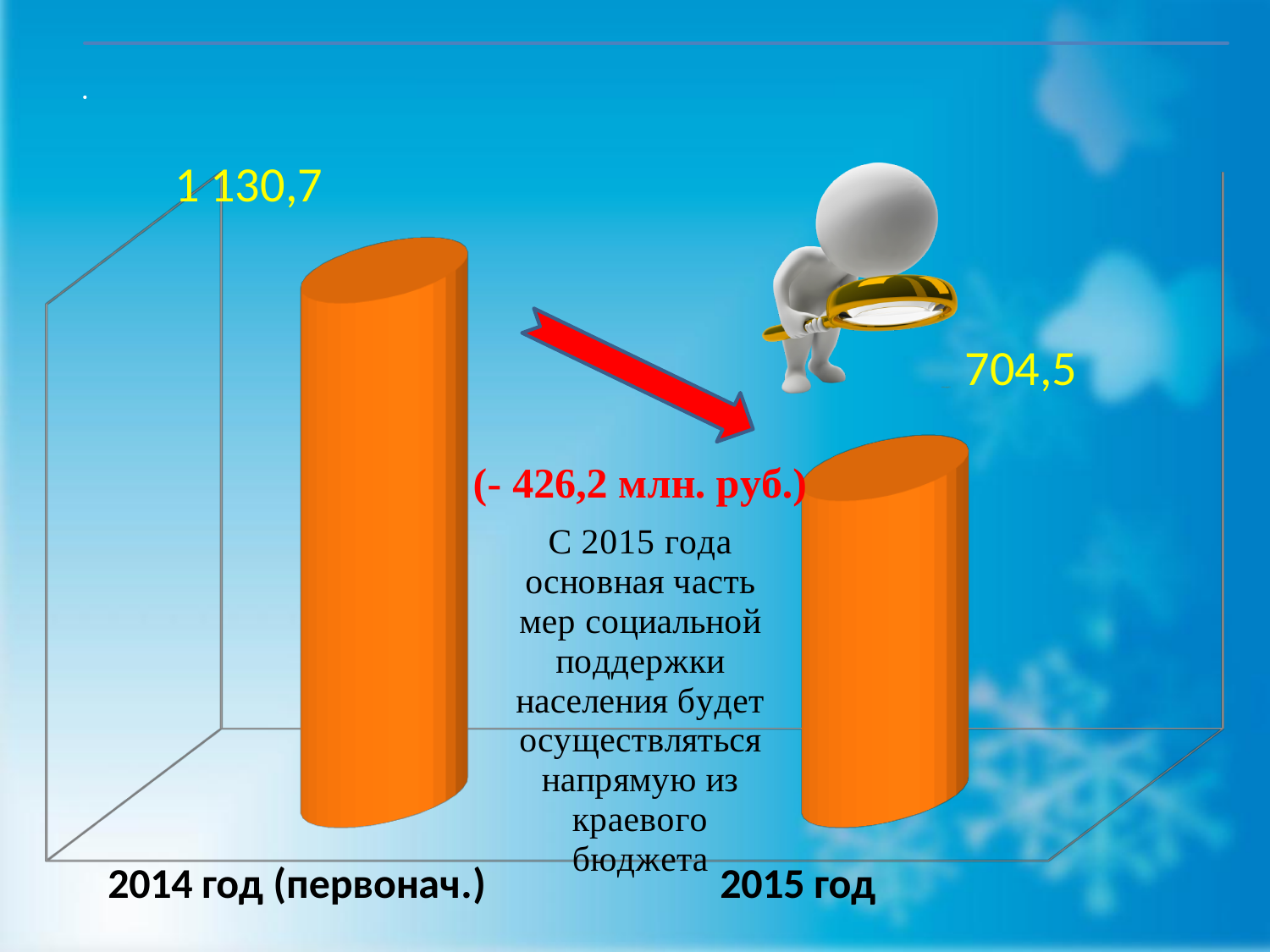
What is the value for 2015 год? 704,5 What is the difference between the values for 2014 год (первонач.) and 2015 год? 426,2 Which category has the highest value? 2014 год (первонач.) Which is larger, the value for 2014 год (первонач.) or the value for 2015 год? 2014 год (первонач.) Do the values rise or fall from 2014 год (первонач.) to 2015 год? fall What kind of chart is shown on the slide? bar chart How many categories are shown in the chart? 2 Which category has the lowest value? 2015 год What change in млн. руб. is printed in red between the two bars? (- 426,2 млн. руб.) What is the value for 2014 год (первонач.)? 1 130,7 What colour are the bars in the chart? orange